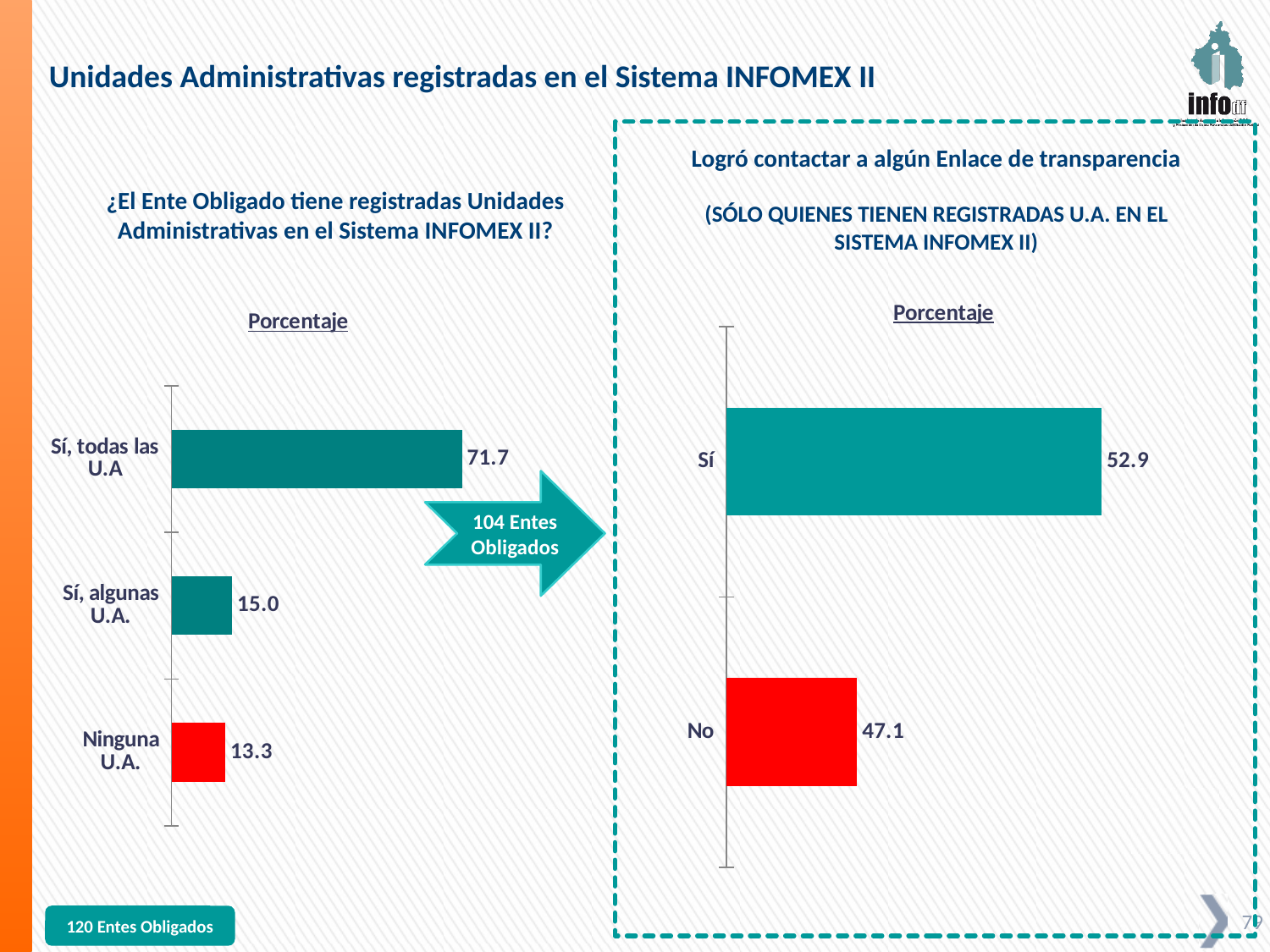
In the right chart (Logró contactar a algún Enlace de transparencia), what is the value for 'No'? 47.1 In the right chart (Logró contactar a algún Enlace de transparencia), what is the value for 'Sí'? 52.9 In the left chart (¿El Ente Obligado tiene registradas Unidades Administrativas en el Sistema INFOMEX II?), which category has the highest value? Sí, todas las U.A In the left chart (¿El Ente Obligado tiene registradas Unidades Administrativas en el Sistema INFOMEX II?), which category has the lowest value? Ninguna U.A. How many categories are shown in the left chart (¿El Ente Obligado tiene registradas Unidades Administrativas en el Sistema INFOMEX II?)? 3 In the left chart (¿El Ente Obligado tiene registradas Unidades Administrativas en el Sistema INFOMEX II?), what is the difference between 'Sí, todas las U.A' and 'Sí, algunas U.A.'? 56.7 In the left chart (¿El Ente Obligado tiene registradas Unidades Administrativas en el Sistema INFOMEX II?), what is the value for 'Sí, todas las U.A'? 71.7 In the right chart (Logró contactar a algún Enlace de transparencia), what is the difference between 'Sí' and 'No'? 5.8 What type of chart is the left chart (¿El Ente Obligado tiene registradas Unidades Administrativas en el Sistema INFOMEX II?)? Bar chart In the right chart (Logró contactar a algún Enlace de transparencia), what colour is the bar for 'No'? Red In the left chart (¿El Ente Obligado tiene registradas Unidades Administrativas en el Sistema INFOMEX II?), what is the value for 'Ninguna U.A.'? 13.3 In the right chart (Logró contactar a algún Enlace de transparencia), which is larger, 'Sí' or 'No'? Sí